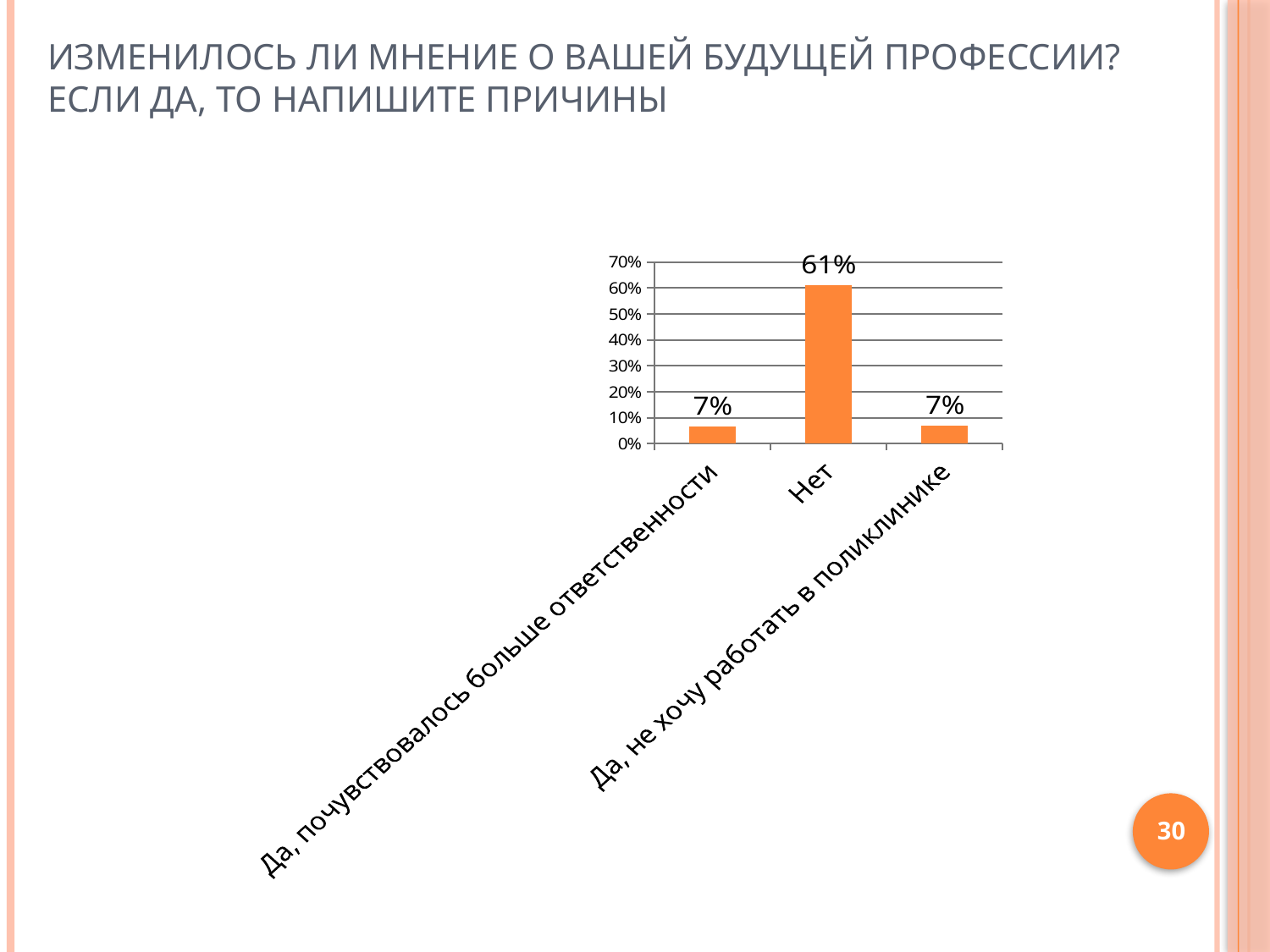
Is the value for "Да, почувствовалось больше ответственности" greater or less than 10%? less What is the value for "Нет"? 61% What kind of chart is shown on the slide? bar chart What is the value for "Да, почувствовалось больше ответственности"? 7% Which is larger, the value for "Нет" or the value for "Да, почувствовалось больше ответственности"? Нет What is the highest value shown on the vertical axis? 70% How many categories are shown in the chart? 3 What colour are the bars in the chart? orange Is the value for "Нет" greater or less than 50%? greater What is the value for "Да, не хочу работать в поликлинике"? 7% Which category has the highest value? Нет What is the difference between the values for "Нет" and "Да, не хочу работать в поликлинике"? 54%